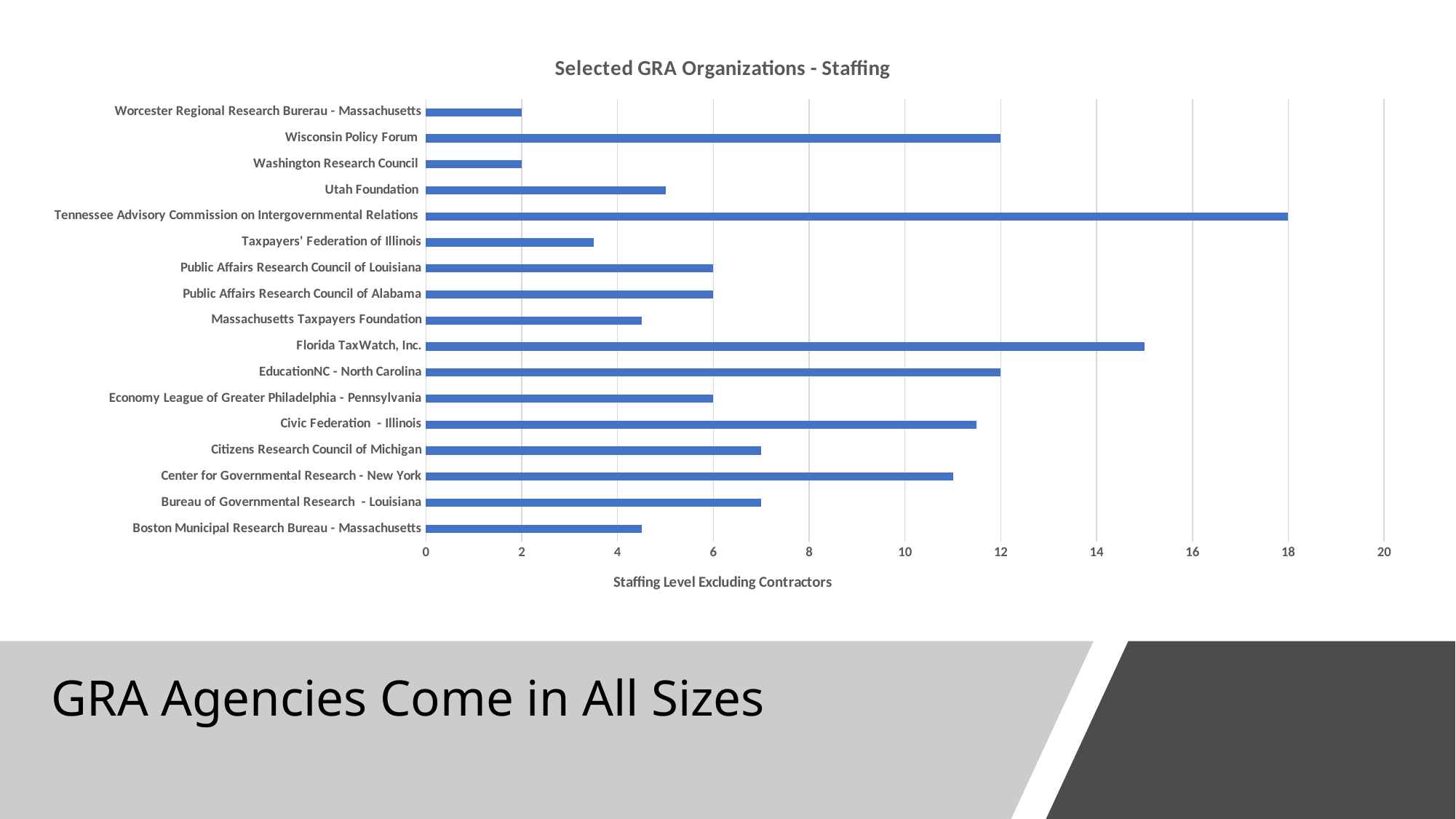
How many organizations are plotted in the chart? 17 What is the label of the horizontal axis? Staffing Level Excluding Contractors What is the title of the chart? Selected GRA Organizations - Staffing What is the staffing level for the Tennessee Advisory Commission on Intergovernmental Relations? 18 What is the staffing level for the Wisconsin Policy Forum? 12 Is the staffing level for the Civic Federation - Illinois greater or less than 10? greater What is the difference in staffing level between the Tennessee Advisory Commission on Intergovernmental Relations and the Wisconsin Policy Forum? 6 Which has a higher staffing level, Florida TaxWatch, Inc. or EducationNC - North Carolina? Florida TaxWatch, Inc. Is the staffing level for the Taxpayers' Federation of Illinois greater or less than 4? less What is the staffing level for the Public Affairs Research Council of Alabama? 6 Which organization has the highest staffing level? Tennessee Advisory Commission on Intergovernmental Relations What type of chart is shown on the slide? bar chart